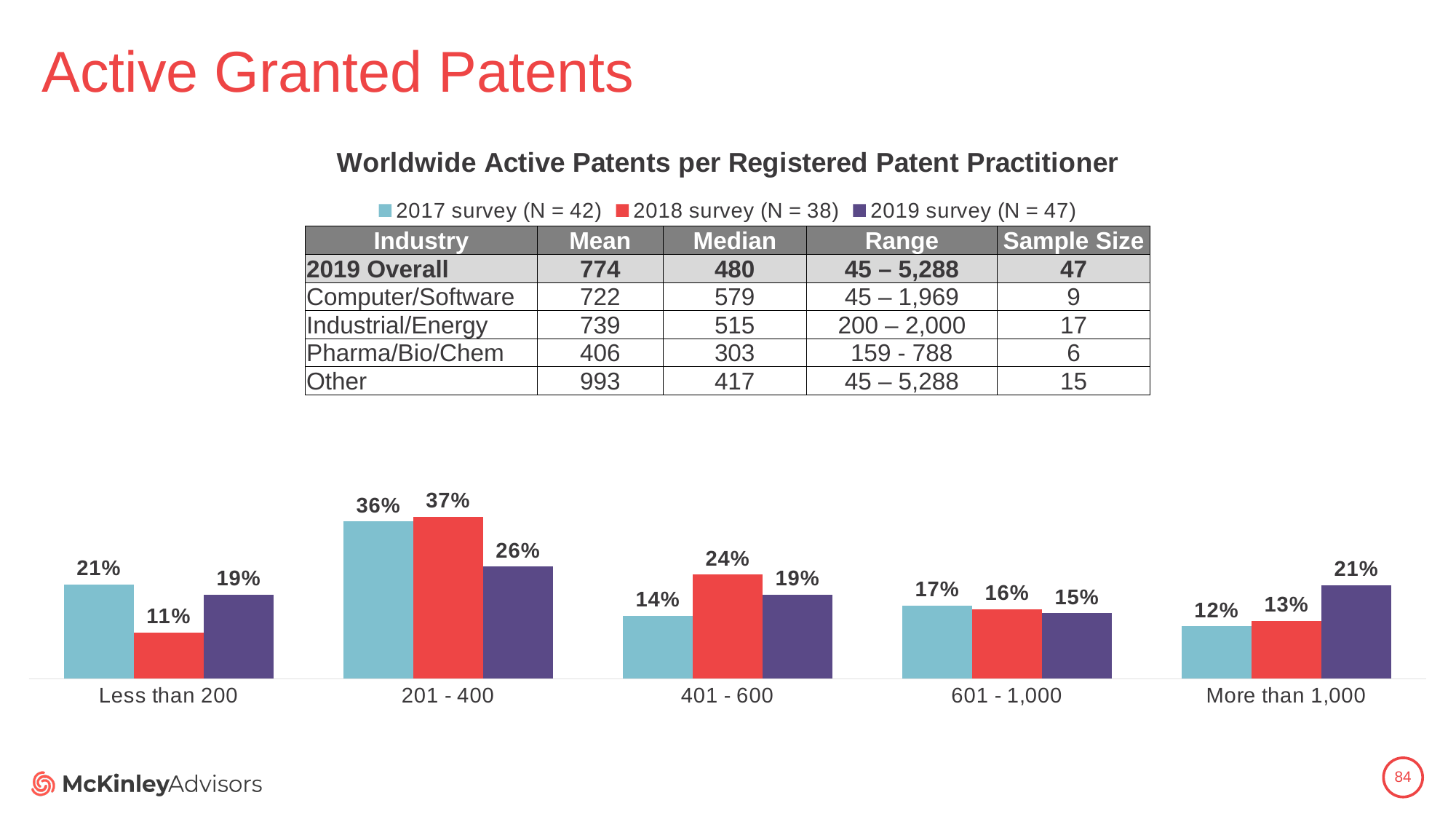
What kind of chart is shown on the slide? Bar chart How many categories are shown on the x axis of the chart? 5 What is the sample size (N) for the 2019 survey shown in the legend? 47 How many series does the chart legend list? 3 Which category has the lowest value for the 2017 survey? More than 1,000 What is the difference between the 2018 survey and 2017 survey values in the '401 - 600' category? 10% What is the value for the 2019 survey in the '201 - 400' category? 26% What is the value for the 2018 survey in the 'Less than 200' category? 11% Which is larger in the 'More than 1,000' category: the 2019 survey value or the 2017 survey value? 2019 survey What is the value for the 2017 survey in the '401 - 600' category? 14% What is the title of the chart? Worldwide Active Patents per Registered Patent Practitioner Which category has the highest value for the 2018 survey? 201 - 400